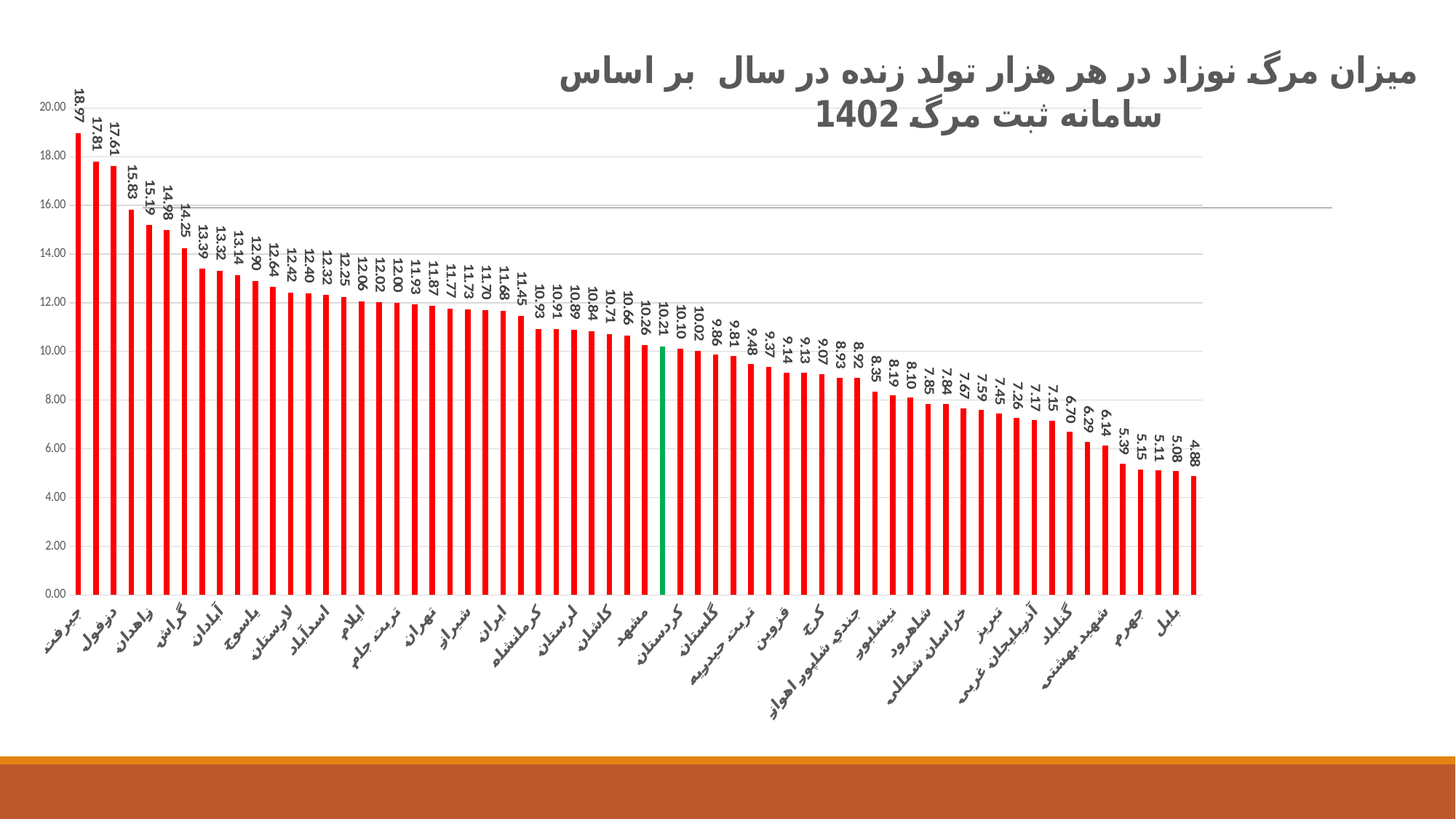
What kind of chart is shown on the slide? bar chart Do the bar values rise or fall from left to right along the x axis? fall Which is larger, the first bar from the left (18.97) or the second bar from the left (17.81)? the first bar (18.97) What is the difference between the highest value (18.97) and the lowest value (4.88) in the chart? 14.09 What is the lowest value shown in the chart? 4.88 What is the highest tick value shown on the vertical axis? 20.00 What is the highest value shown in the chart? 18.97 What is the value of the green bar in the chart? 10.21 What is the value of the second bar from the left? 17.81 Is the value of the green bar greater or less than 12.00? less What colour are most of the bars in the chart? red Is the value of the leftmost bar greater or less than 18.00? greater